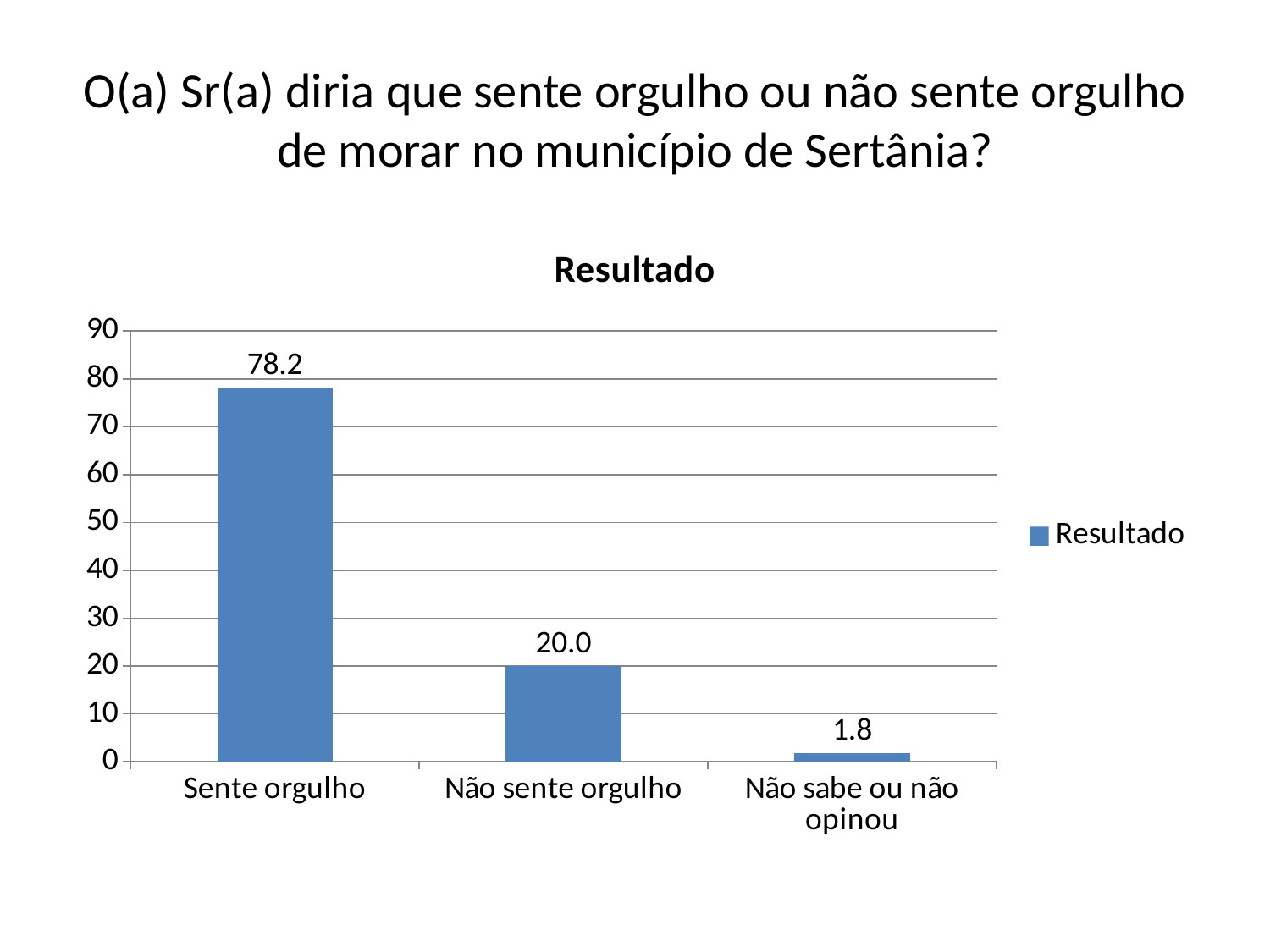
What is the difference between the values for "Sente orgulho" and "Não sente orgulho"? 58.2 What is the title of the chart? Resultado Which is larger, the value for "Não sente orgulho" or the value for "Não sabe ou não opinou"? Não sente orgulho What is the value for "Não sente orgulho"? 20.0 What kind of chart is shown? bar chart Is the value for "Sente orgulho" greater or less than 70? greater Which category has the lowest value? Não sabe ou não opinou How many categories are shown on the x axis? 3 What is the value for "Sente orgulho"? 78.2 Which category has the highest value? Sente orgulho What is the value for "Não sabe ou não opinou"? 1.8 How many series does the legend list? 1